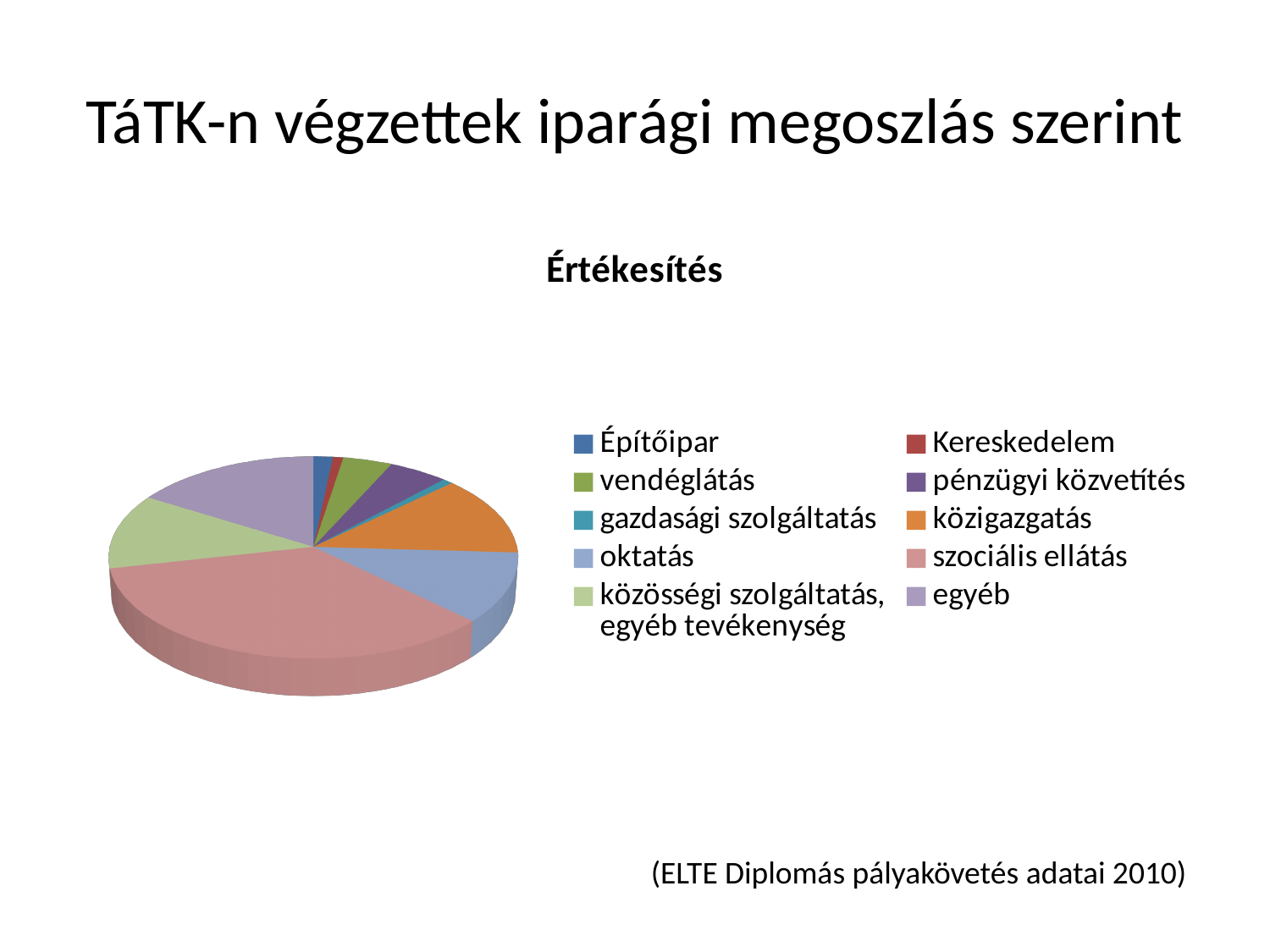
How many categories does the chart's legend list? 10 What colour is the közigazgatás slice in the chart? orange Which slice is larger, szociális ellátás or egyéb? szociális ellátás Which slice is larger, közösségi szolgáltatás, egyéb tevékenység or Kereskedelem? közösségi szolgáltatás, egyéb tevékenység Which slice is larger, közigazgatás or vendéglátás? közigazgatás What kind of chart is shown on the slide? pie chart What is the title of the chart? Értékesítés Which category has the largest slice of the pie? szociális ellátás